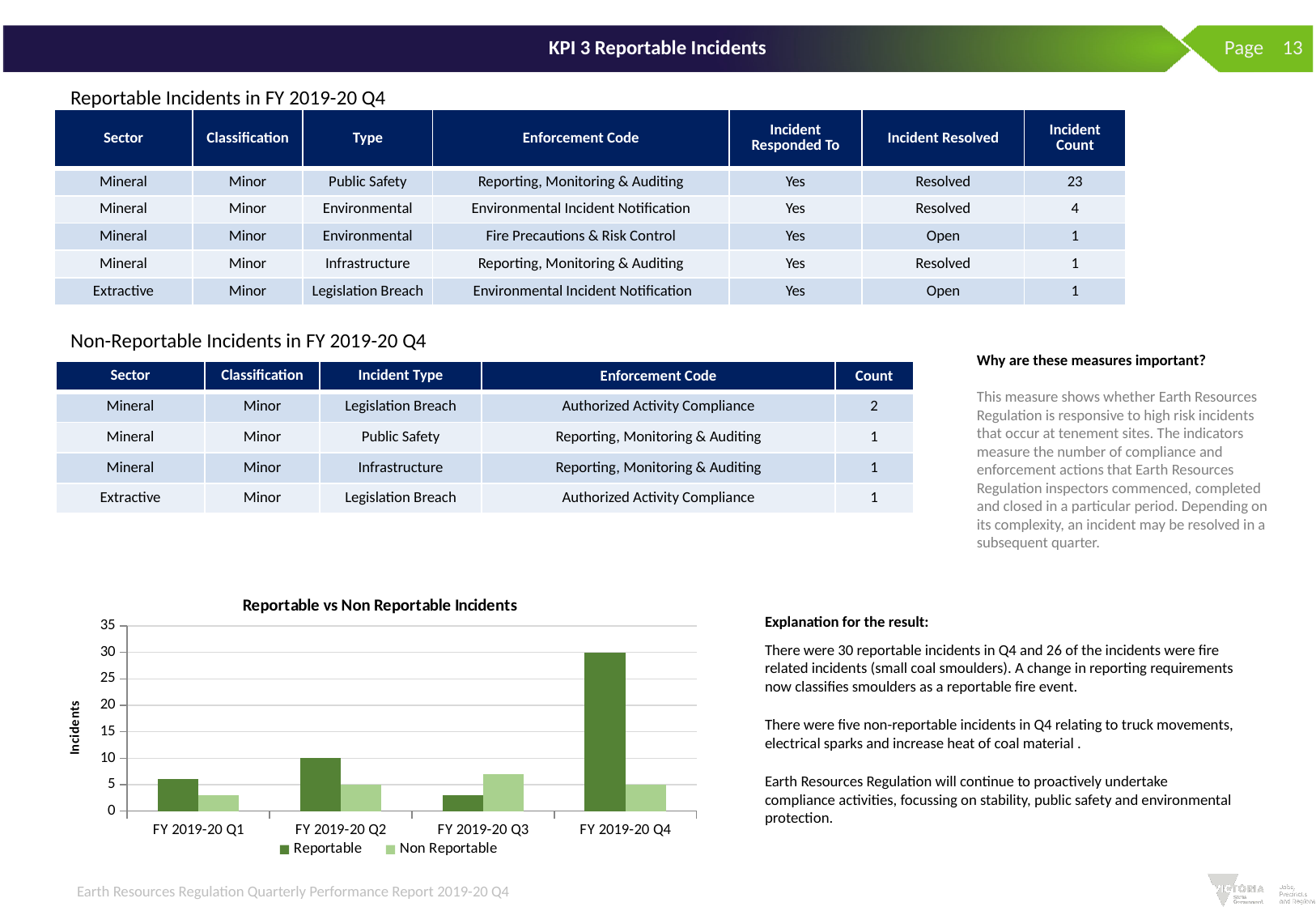
In the "Reportable vs Non Reportable Incidents" chart, which quarter has the lowest number of Reportable incidents? FY 2019-20 Q3 In the "Reportable vs Non Reportable Incidents" chart, which series is larger for FY 2019-20 Q2, Reportable or Non Reportable? Reportable In the "Reportable vs Non Reportable Incidents" chart, what is the Reportable value for FY 2019-20 Q4? 30 In the "Reportable vs Non Reportable Incidents" chart, is the Reportable value for FY 2019-20 Q1 greater or less than 10? less In the "Reportable vs Non Reportable Incidents" chart, which quarter has the highest number of Reportable incidents? FY 2019-20 Q4 What is the label on the vertical axis of the "Reportable vs Non Reportable Incidents" chart? Incidents How many quarters are shown on the x axis of the "Reportable vs Non Reportable Incidents" chart? 4 In the "Reportable vs Non Reportable Incidents" chart, which series is larger for FY 2019-20 Q3, Reportable or Non Reportable? Non Reportable In the "Reportable vs Non Reportable Incidents" chart, what is the Non Reportable value for FY 2019-20 Q4? 5 How many series does the legend of the "Reportable vs Non Reportable Incidents" chart list? 2 What kind of chart is the "Reportable vs Non Reportable Incidents" chart? bar chart In the "Reportable vs Non Reportable Incidents" chart, what is the difference between the Reportable and Non Reportable values for FY 2019-20 Q4? 25